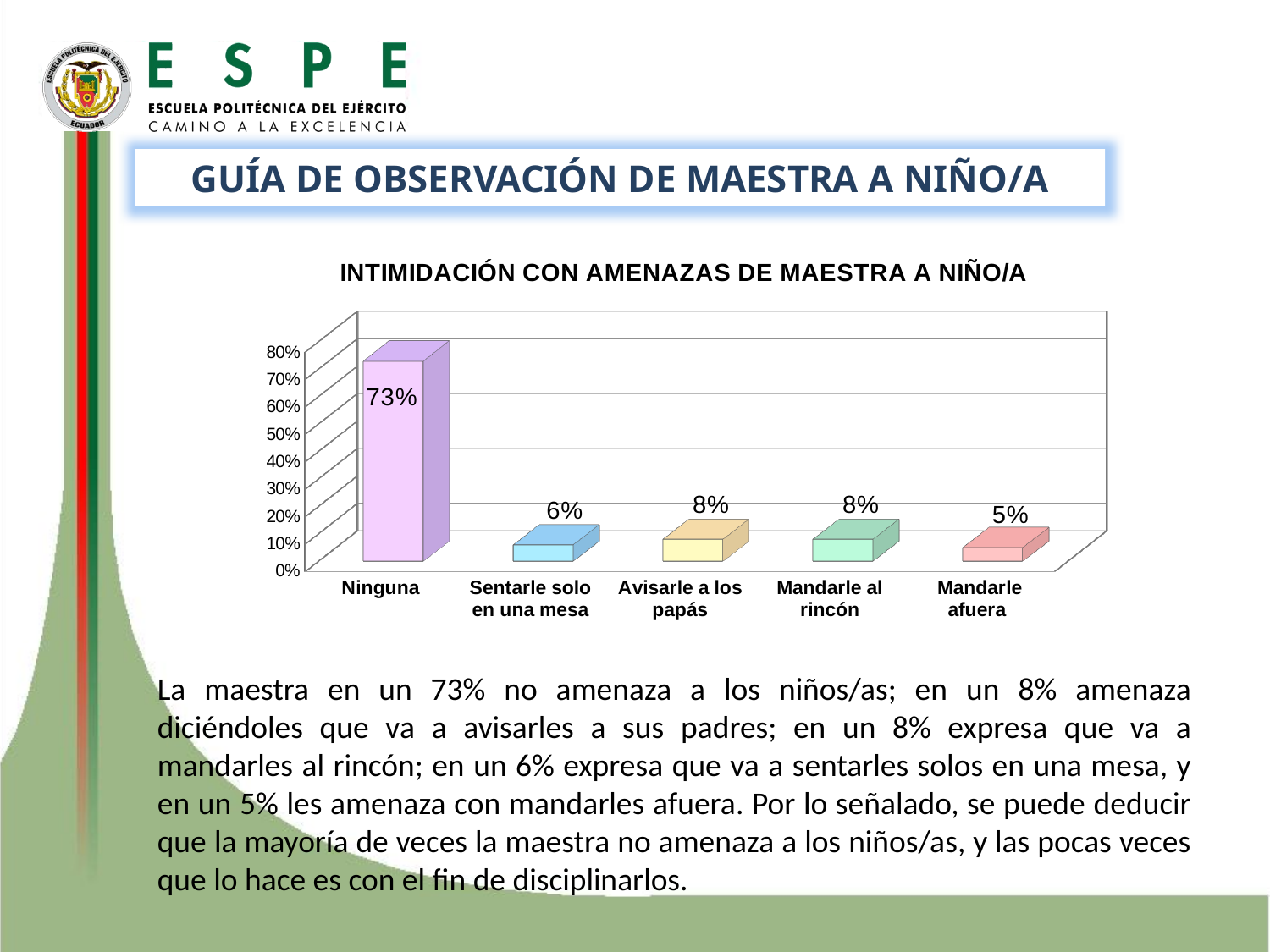
Which category has the lowest value? Mandarle afuera Which is larger, the value for Sentarle solo en una mesa or the value for Mandarle afuera? Sentarle solo en una mesa How many categories are shown on the x axis? 5 What is the difference between the values for Ninguna and Mandarle al rincón? 65% What is the value for Ninguna? 73% What kind of chart is shown? bar chart What is the title of the chart? INTIMIDACIÓN CON AMENAZAS DE MAESTRA A NIÑO/A Which category has the highest value? Ninguna What is the value for Mandarle afuera? 5% What is the value for Sentarle solo en una mesa? 6% What is the value for Avisarle a los papás? 8% Is the value for Ninguna greater or less than 50%? greater